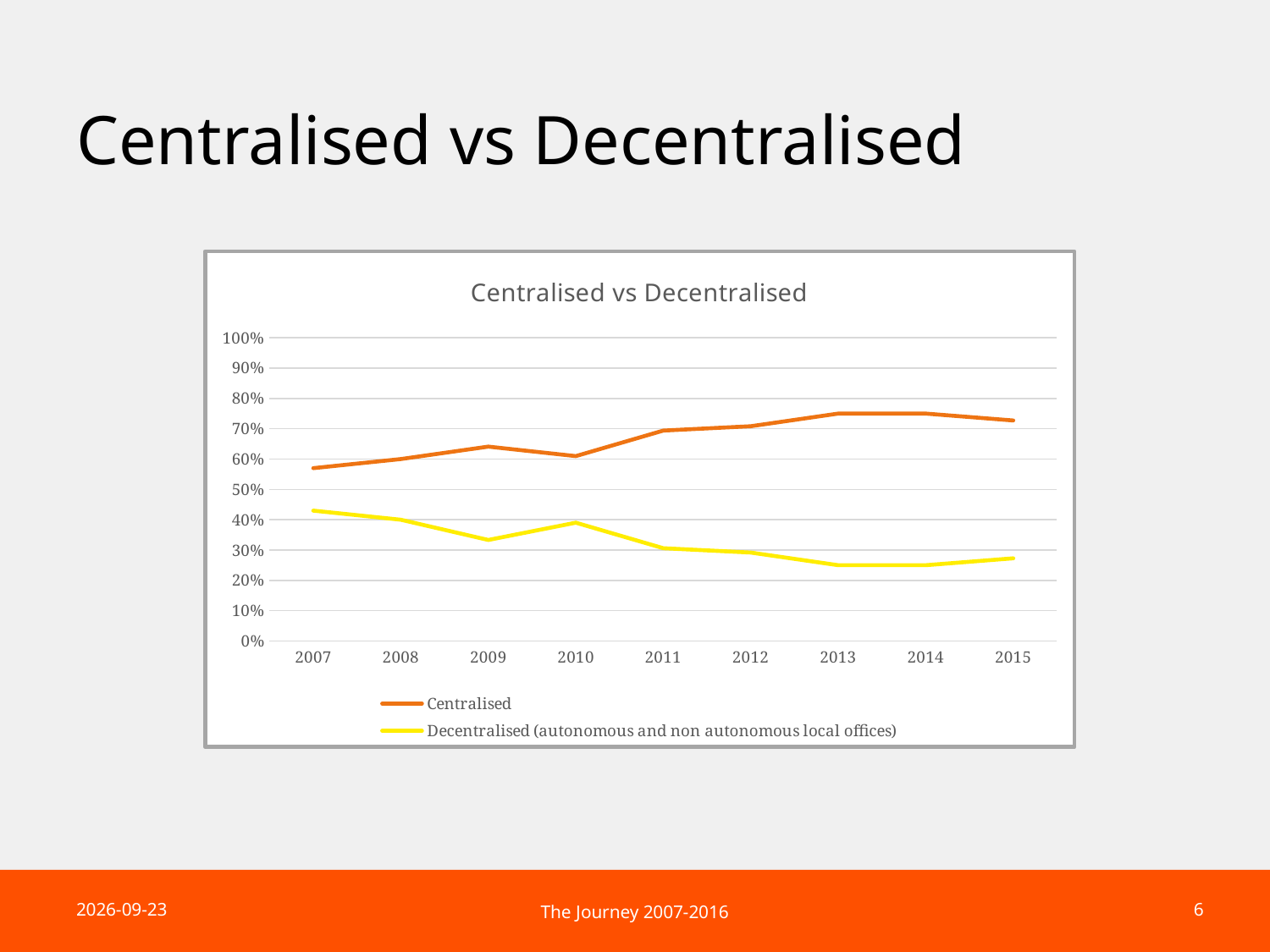
How many years are plotted along the x axis? 9 What kind of chart is shown on the slide? Line chart How many series does the legend list? 2 In which year is the Centralised series at its lowest? 2007 What is the title of the chart? Centralised vs Decentralised In 2015, which series has the higher value, Centralised or Decentralised? Centralised Is the Centralised value for 2013 greater or less than 70%? greater Is the Decentralised value for 2013 greater or less than 30%? less Is the Centralised value for 2007 greater or less than 50%? greater Does the Decentralised series generally rise or fall from 2007 to 2015? Fall Which series is drawn in yellow? Decentralised (autonomous and non autonomous local offices)